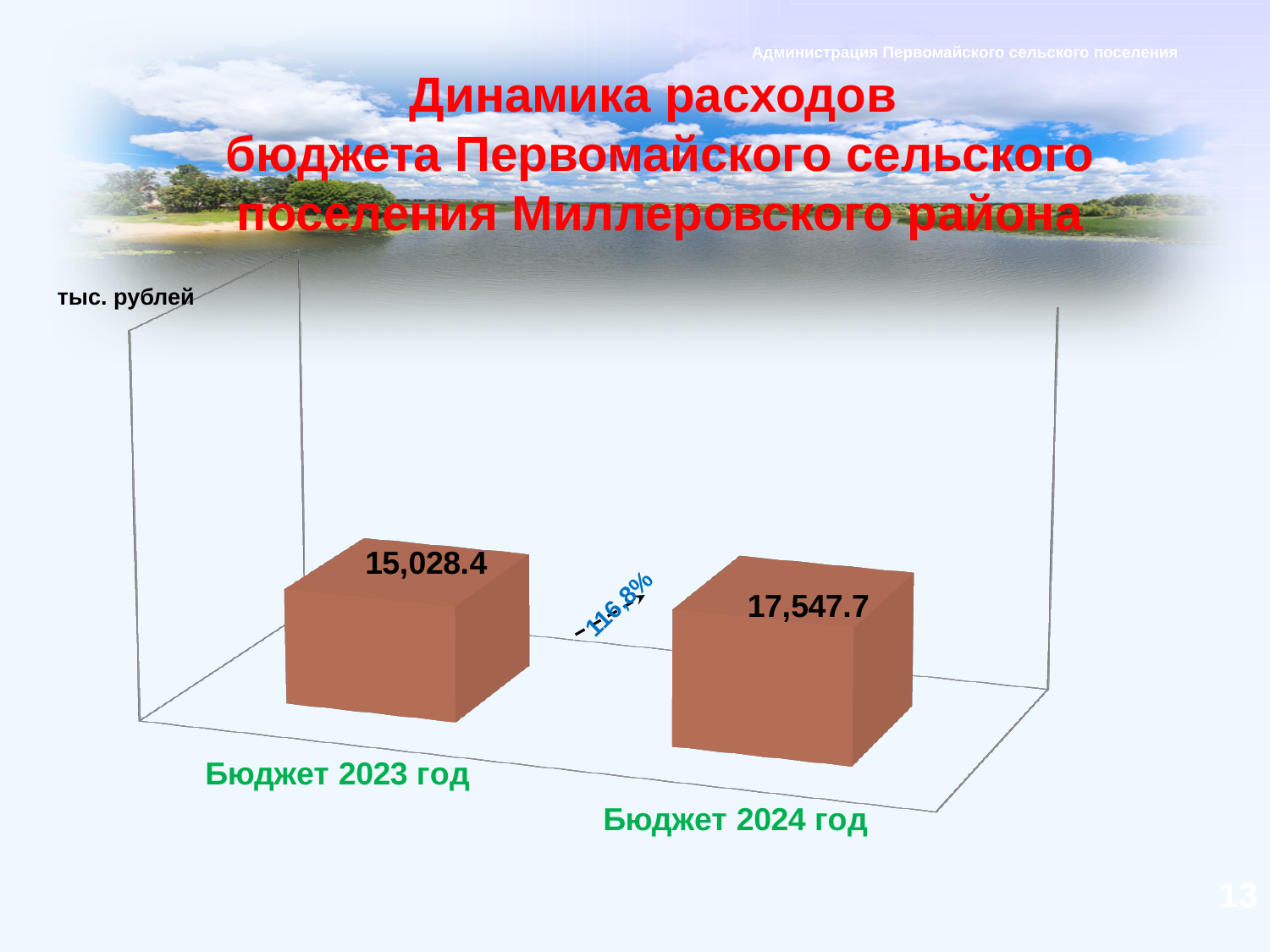
Which category has the highest value? Бюджет 2024 год What is the difference between the values for Бюджет 2024 год and Бюджет 2023 год? 2,519.3 What is the value for Бюджет 2024 год? 17,547.7 Do the values rise or fall from Бюджет 2023 год to Бюджет 2024 год? Rise Which is larger, the value for Бюджет 2023 год or the value for Бюджет 2024 год? Бюджет 2024 год What unit of measurement is indicated on the chart? тыс. рублей What is the value for Бюджет 2023 год? 15,028.4 Which category has the lowest value? Бюджет 2023 год What kind of chart is shown on the slide? Bar chart What percentage is shown in the annotation between the two bars? 116.8% How many categories are shown in the chart? 2